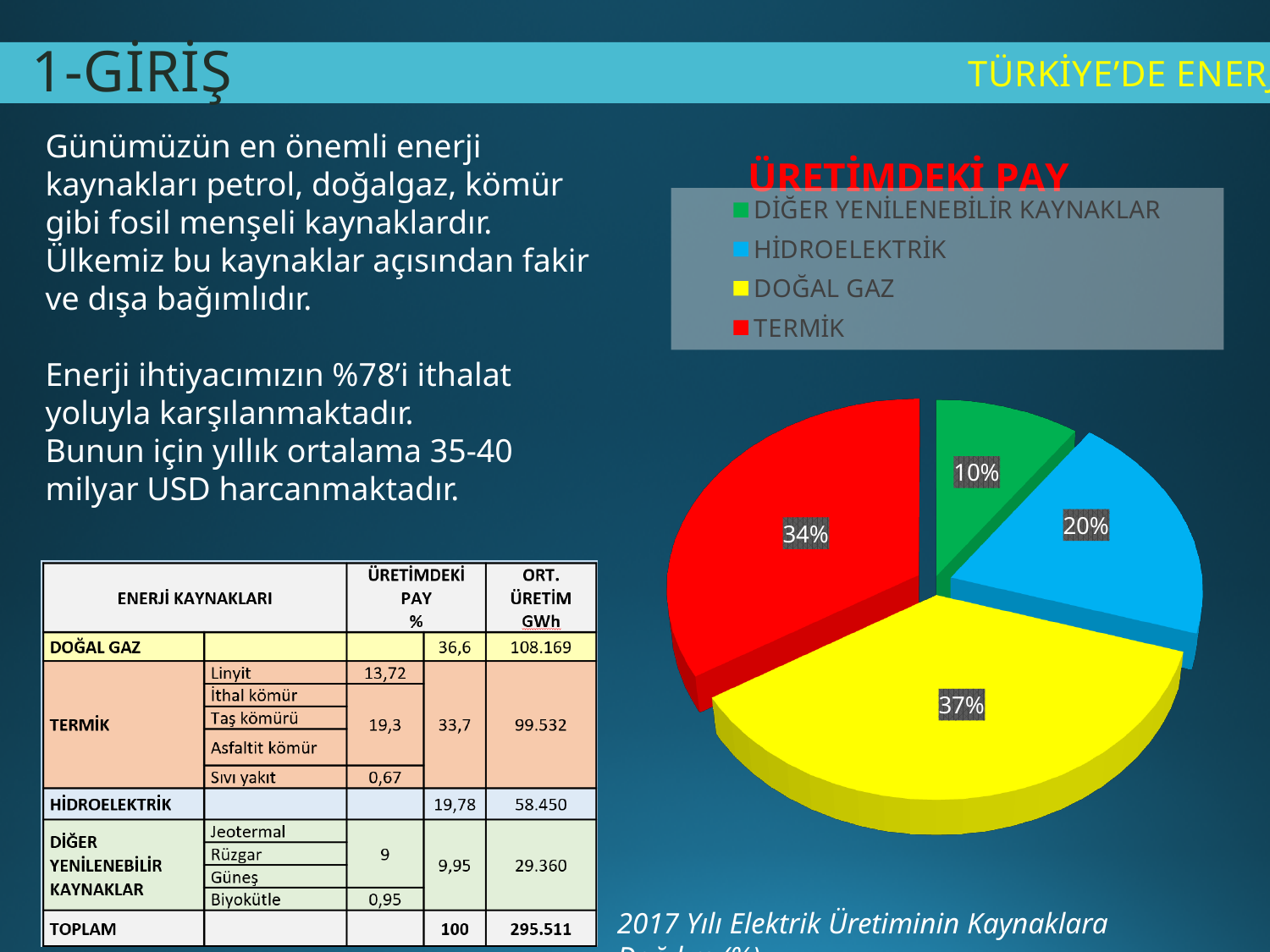
What share of the pie does DİĞER YENİLENEBİLİR KAYNAKLAR have? 10% What share of the pie does TERMİK have? 34% Which is larger, the TERMİK slice or the HİDROELEKTRİK slice? TERMİK What is the difference in percentage points between the HİDROELEKTRİK slice and the DİĞER YENİLENEBİLİR KAYNAKLAR slice? 10 What share of the pie does HİDROELEKTRİK have? 20% Which category has the largest slice of the pie? DOĞAL GAZ What kind of chart is shown on the slide? pie chart What is the title of the pie chart? ÜRETİMDEKİ PAY Which category has the smallest slice of the pie? DİĞER YENİLENEBİLİR KAYNAKLAR What colour is the DOĞAL GAZ slice in the pie chart? yellow How many categories does the legend of the pie chart list? 4 What share of the pie does DOĞAL GAZ have? 37%